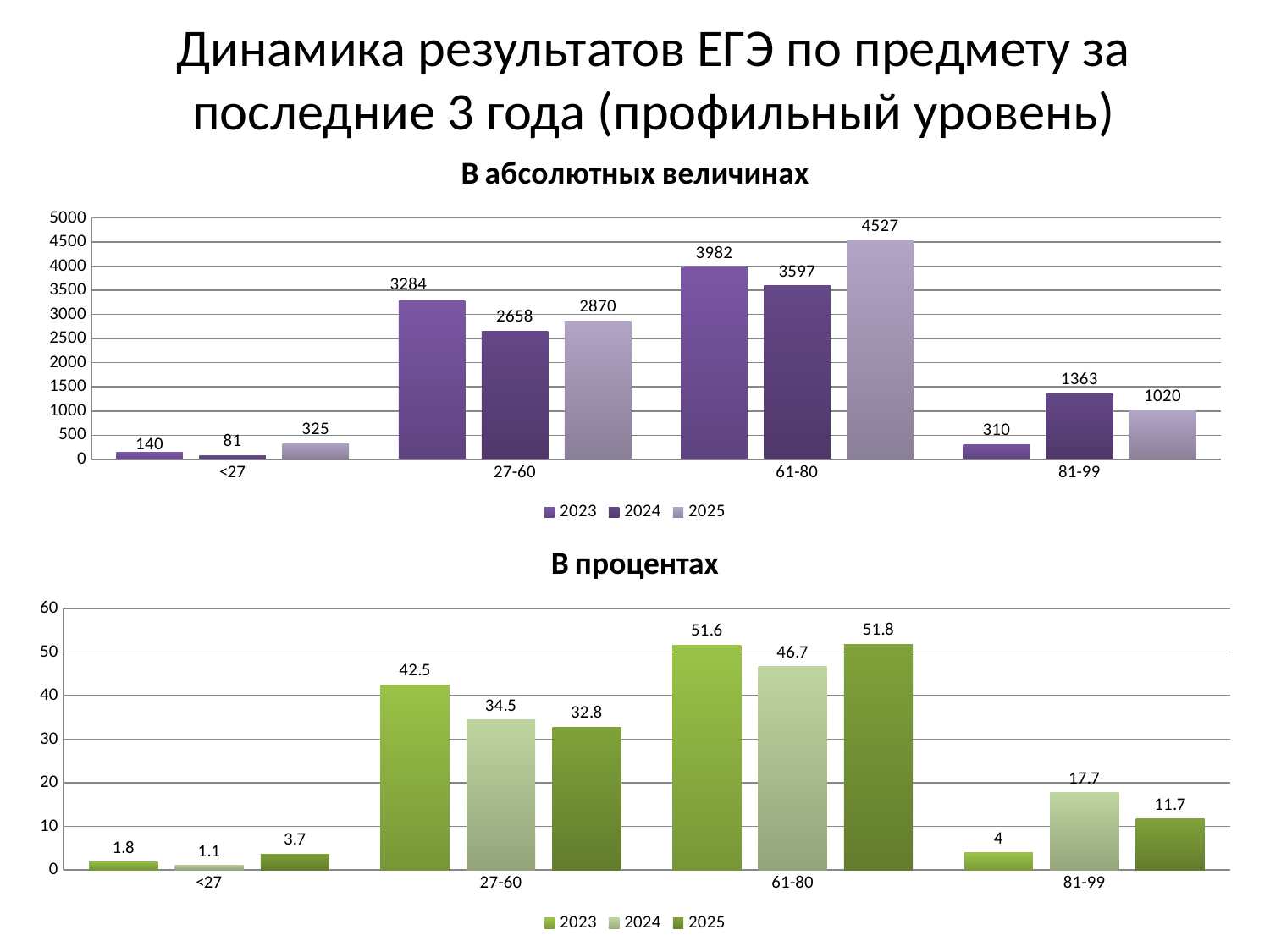
In the chart 'В процентах', what is the value for 2023 in the 81-99 category? 4 In the chart 'В абсолютных величинах', what is the difference between the 2023 and 2024 values in the 27-60 category? 626 In the chart 'В процентах', do the 2024 values rise or fall from the 27-60 category to the 61-80 category? Rise In the chart 'В абсолютных величинах', how many series does the legend list? 3 In the chart 'В абсолютных величинах', what is the value for 2025 in the 61-80 category? 4527 In the chart 'В абсолютных величинах', which is larger in the 81-99 category: the 2024 value or the 2025 value? 2024 What kind of chart is 'В процентах'? Bar chart In the chart 'В процентах', what is the value for 2024 in the 61-80 category? 46.7 In the chart 'В абсолютных величинах', which category has the highest value for 2023? 61-80 In the chart 'В абсолютных величинах', what is the value for 2024 in the <27 category? 81 In the chart 'В процентах', how many categories are shown on the x axis? 4 In the chart 'В процентах', which category has the lowest value for 2025? <27